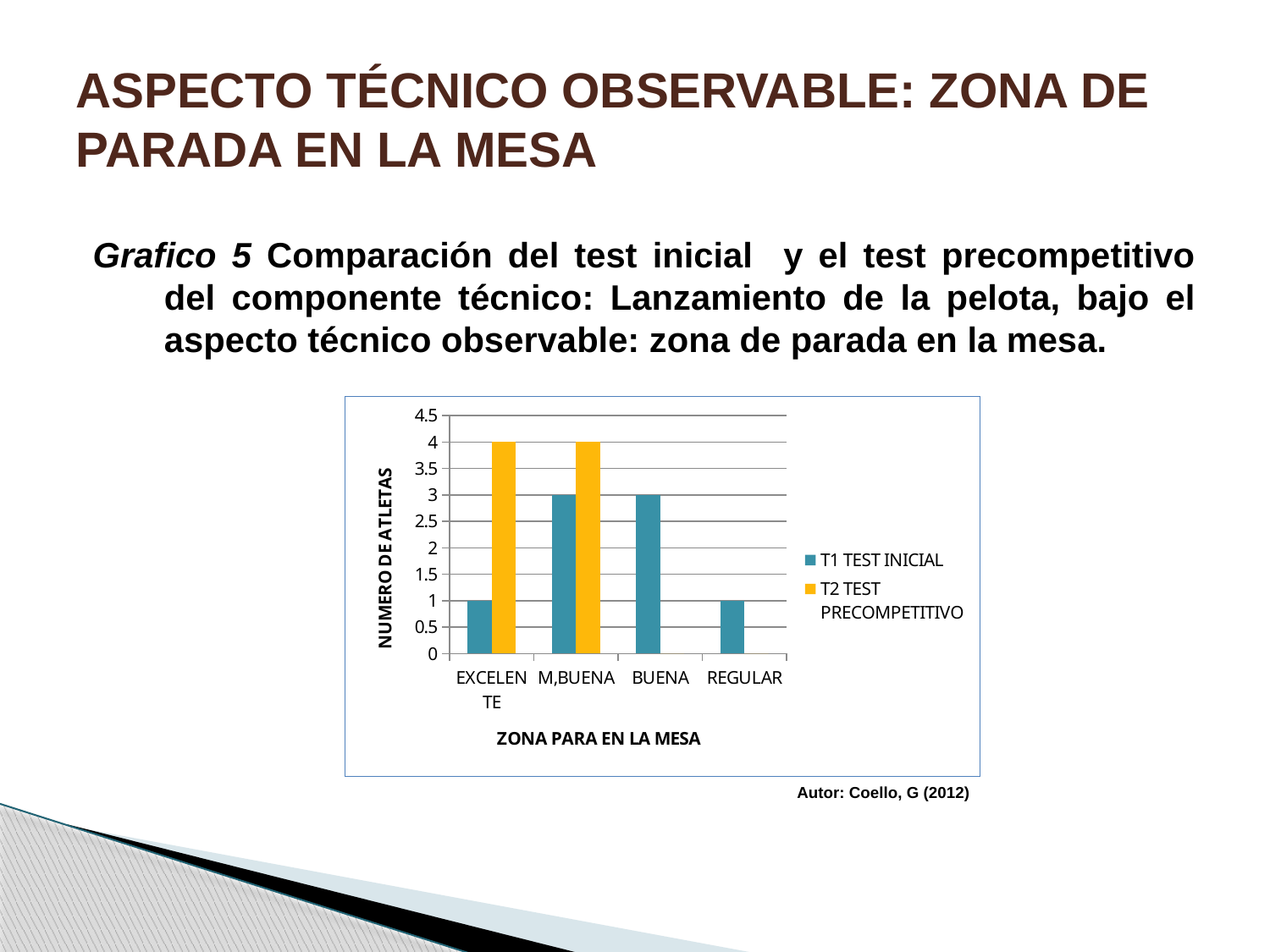
Which colour represents T2 TEST PRECOMPETITIVO in the chart? Yellow Is the value for T2 TEST PRECOMPETITIVO in the M,BUENA category greater or less than 3.5? greater What is the value for T1 TEST INICIAL in the M,BUENA category? 3 How many categories are shown on the x axis? 4 What is the difference between T2 TEST PRECOMPETITIVO and T1 TEST INICIAL in the EXCELENTE category? 3 What is the value for T2 TEST PRECOMPETITIVO in the EXCELENTE category? 4 What is the value for T1 TEST INICIAL in the REGULAR category? 1 What is the value for T1 TEST INICIAL in the EXCELENTE category? 1 What is the label of the y axis? NUMERO DE ATLETAS How many series does the legend list? 2 Which category has the highest value for T1 TEST INICIAL, EXCELENTE or BUENA? BUENA What kind of chart is shown on the slide? Bar chart